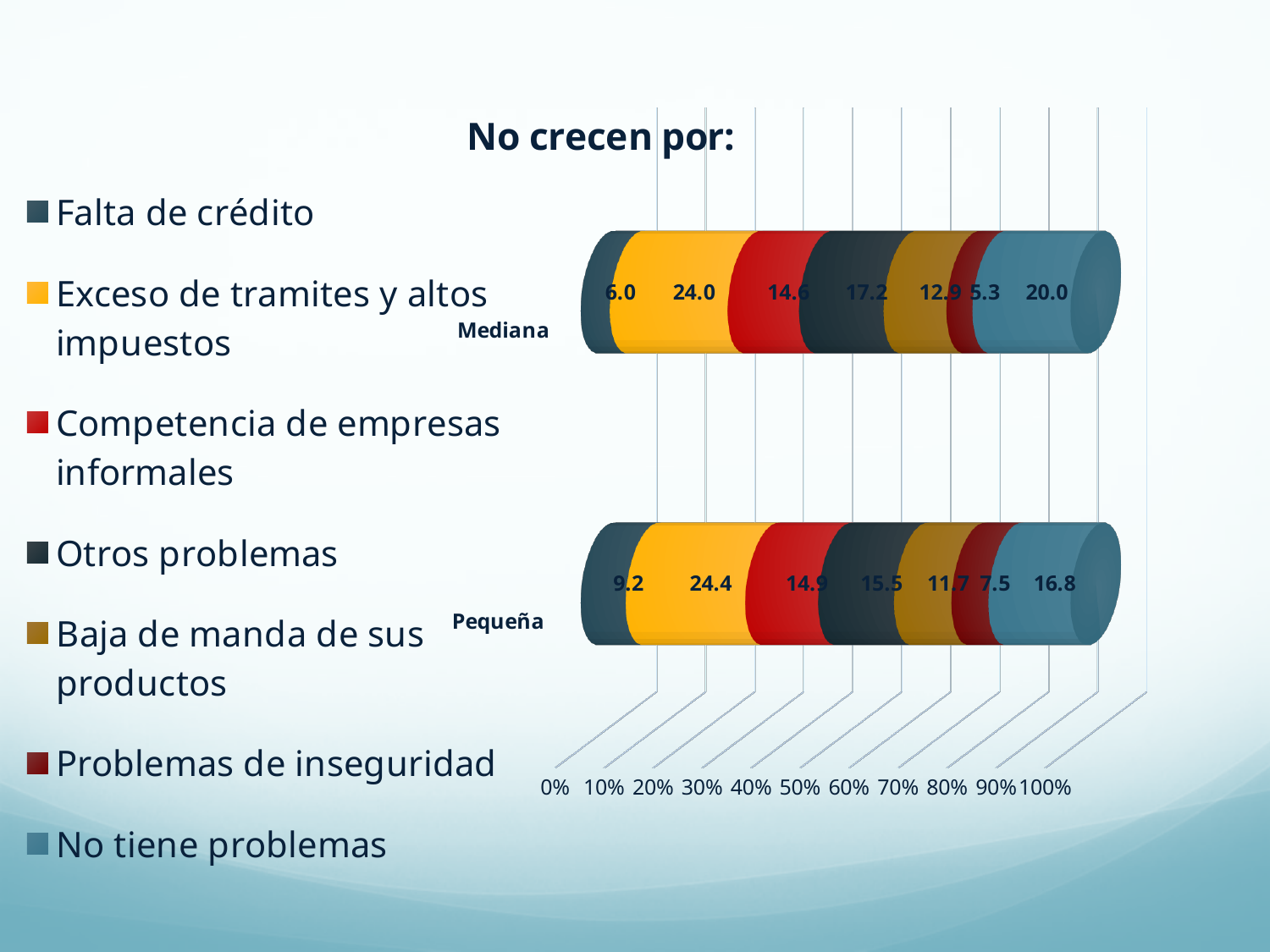
What is the title of the chart? No crecen por: What is the value of No tiene problemas for Pequeña? 16.8 Which series has the smallest value in the Pequeña bar? Problemas de inseguridad What is the difference between the No tiene problemas values for Mediana and Pequeña? 3.2 How many categories (bars) does the chart show? 2 What is the value of Falta de crédito for Mediana? 6.0 What is the value of Problemas de inseguridad for Mediana? 5.3 What is the value of Exceso de tramites y altos impuestos for Pequeña? 24.4 How many series does the legend list? 7 Is the value of Falta de crédito larger for Mediana or for Pequeña? Pequeña Which series has the largest value in the Mediana bar? Exceso de tramites y altos impuestos What kind of chart is shown on the slide? Stacked bar chart